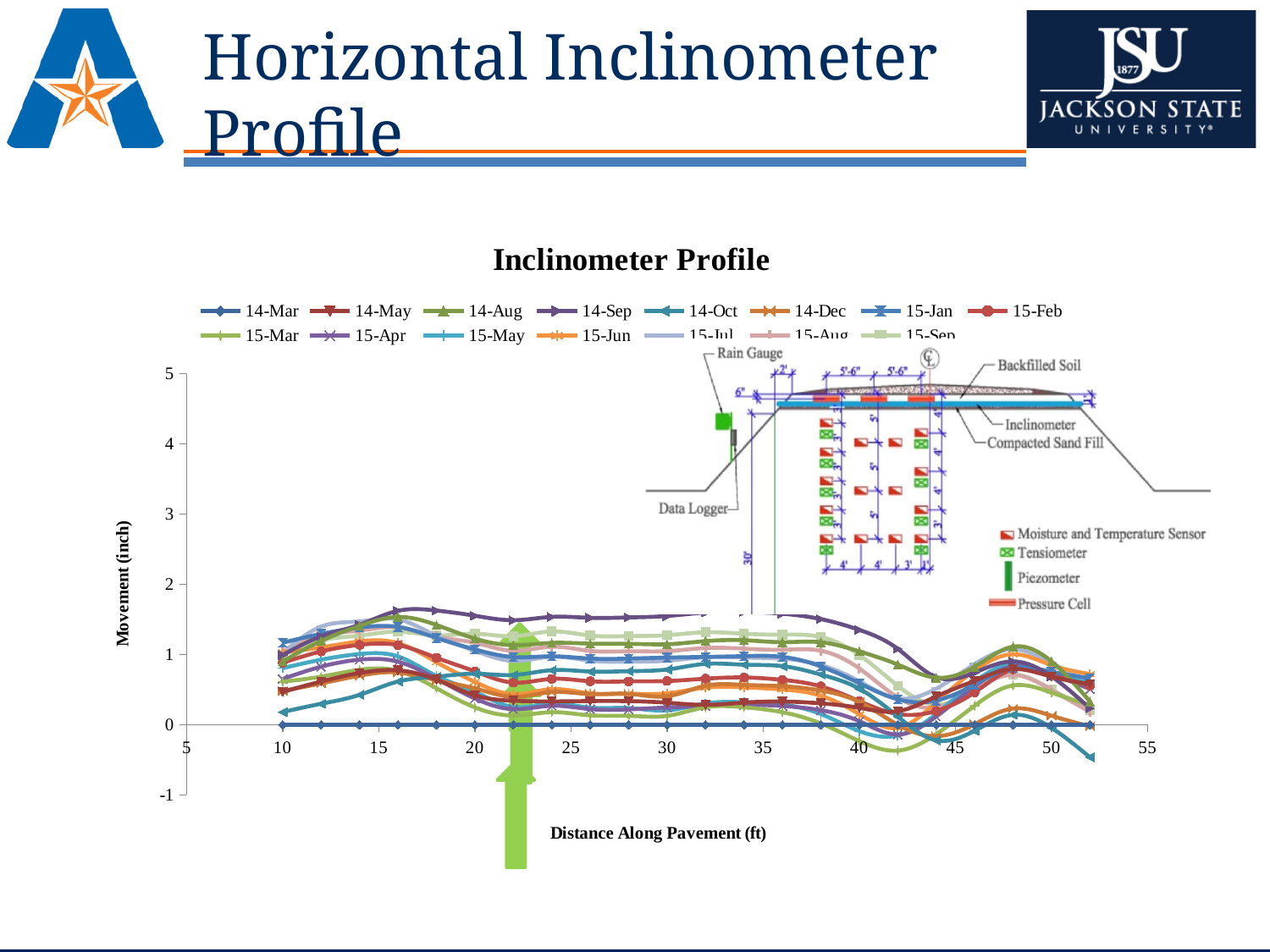
Is the value for 14-Mar at a distance of 30 ft greater or less than 1? less How many series are listed in the chart legend? 15 What kind of chart is shown on the slide? line chart Which series has the highest movement at a distance of 30 ft? 14-Sep Is the value for 14-Sep at a distance of 30 ft greater or less than 1? greater What is the label of the vertical axis? Movement (inch) At a distance of 30 ft, which series has the larger movement, 14-Sep or 14-Mar? 14-Sep Which series stays flat at 0 across the whole distance range? 14-Mar What is the title of the chart? Inclinometer Profile Does the 14-Sep series rise or fall between 40 ft and 52 ft? fall What is the highest value shown on the vertical axis? 5 Is the value for 14-Sep at a distance of 30 ft greater or less than 2? less